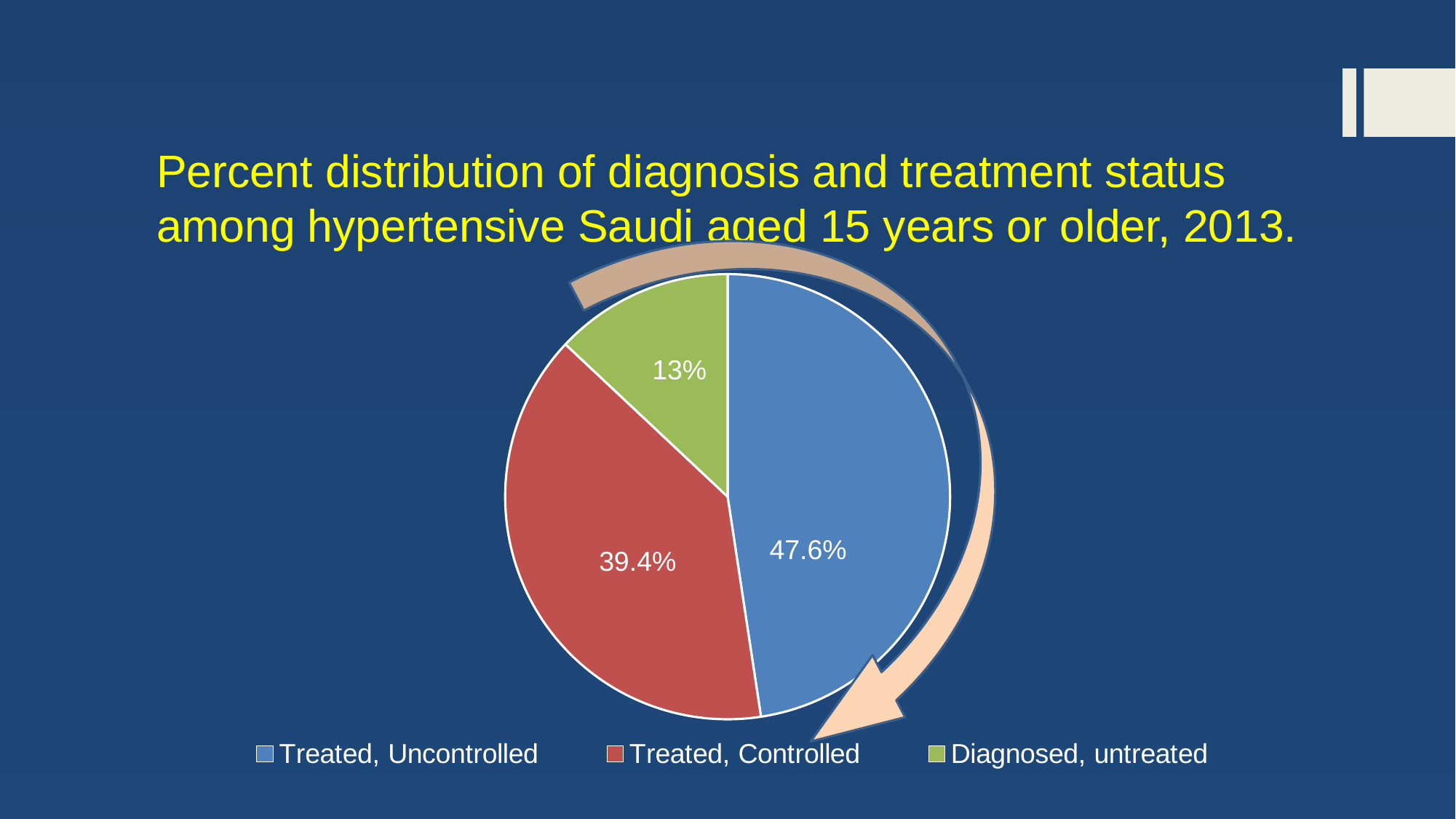
What colour is the Treated, Controlled slice? red What is the difference in percentage points between the Treated, Controlled and Diagnosed, untreated slices? 26.4 Which category has the largest slice of the pie? Treated, Uncontrolled What is the difference in percentage points between the Treated, Uncontrolled and Treated, Controlled slices? 8.2 Which category has the smallest slice of the pie? Diagnosed, untreated What kind of chart is shown on the slide? pie chart Which slice is larger: Treated, Controlled or Diagnosed, untreated? Treated, Controlled What percentage of the pie is labelled Diagnosed, untreated? 13% What percentage of the pie is labelled Treated, Uncontrolled? 47.6% What percentage of the pie is labelled Treated, Controlled? 39.4% What is the title of the slide containing the pie chart? Percent distribution of diagnosis and treatment status among hypertensive Saudi aged 15 years or older, 2013. How many slices does the pie chart have? 3